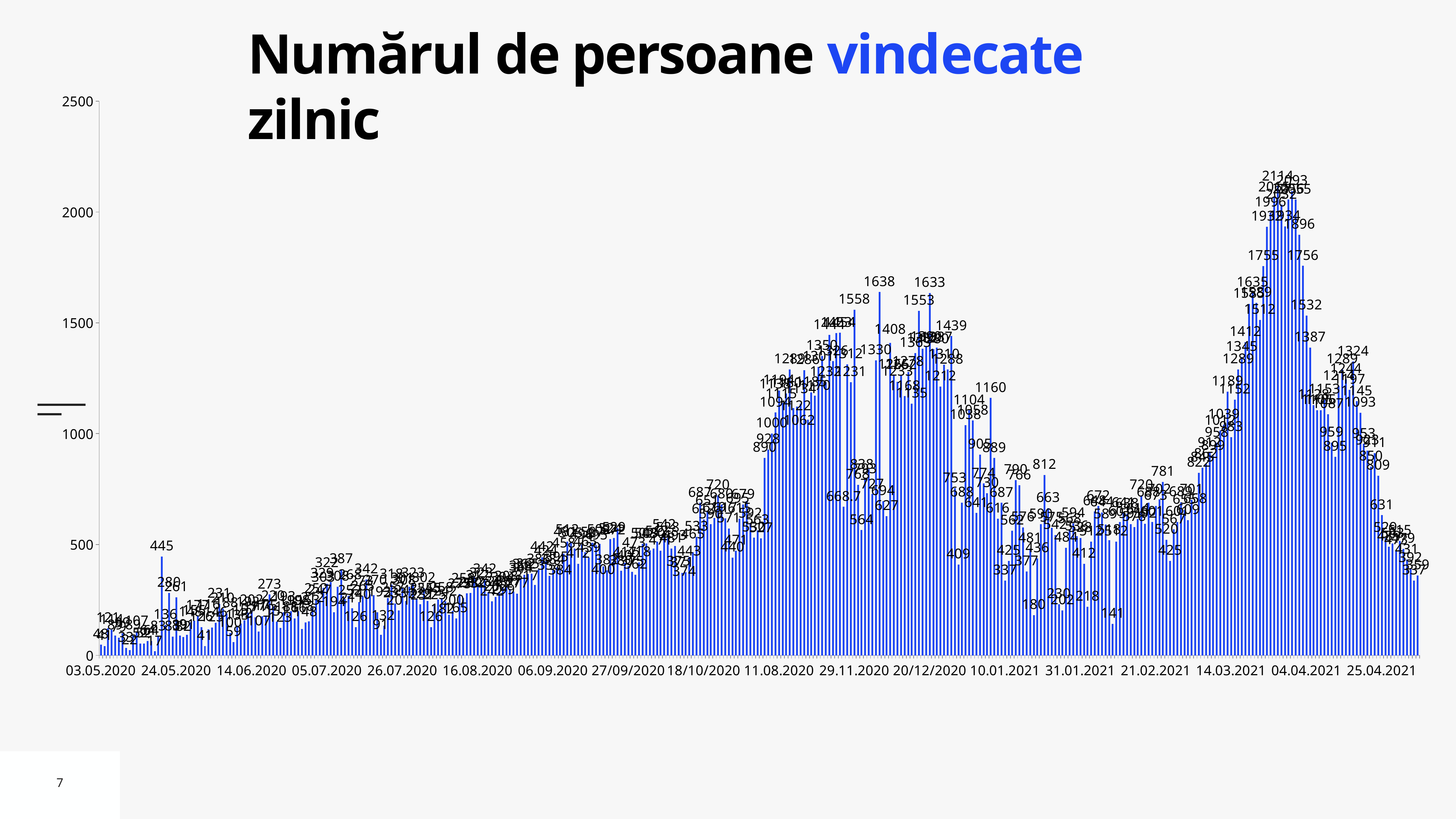
Do the values generally rise or fall between 21.02.2021 and 04.04.2021? rise What is the title of the chart? Numărul de persoane vindecate zilnic What is the difference between the highest value, 2114, and the value labeled 1896 shortly after it? 218 Which is larger, the peak labeled 1638 or the peak labeled 1633? 1638 Is the value of the first bar, at 03.05.2020, greater or less than 500? less What is the highest value labeled on the chart? 2114 Is the tallest bar, near 04.04.2021, greater or less than 2000? greater What kind of chart is shown on the slide? bar chart Do the values generally rise or fall between 04.04.2021 and 25.04.2021? fall What is the difference between the peak labeled 1638 and the nearby peak labeled 1558? 80 What is the topmost tick value shown on the vertical axis? 2500 Is the value of the bar at 14.06.2020 greater or less than 500? less